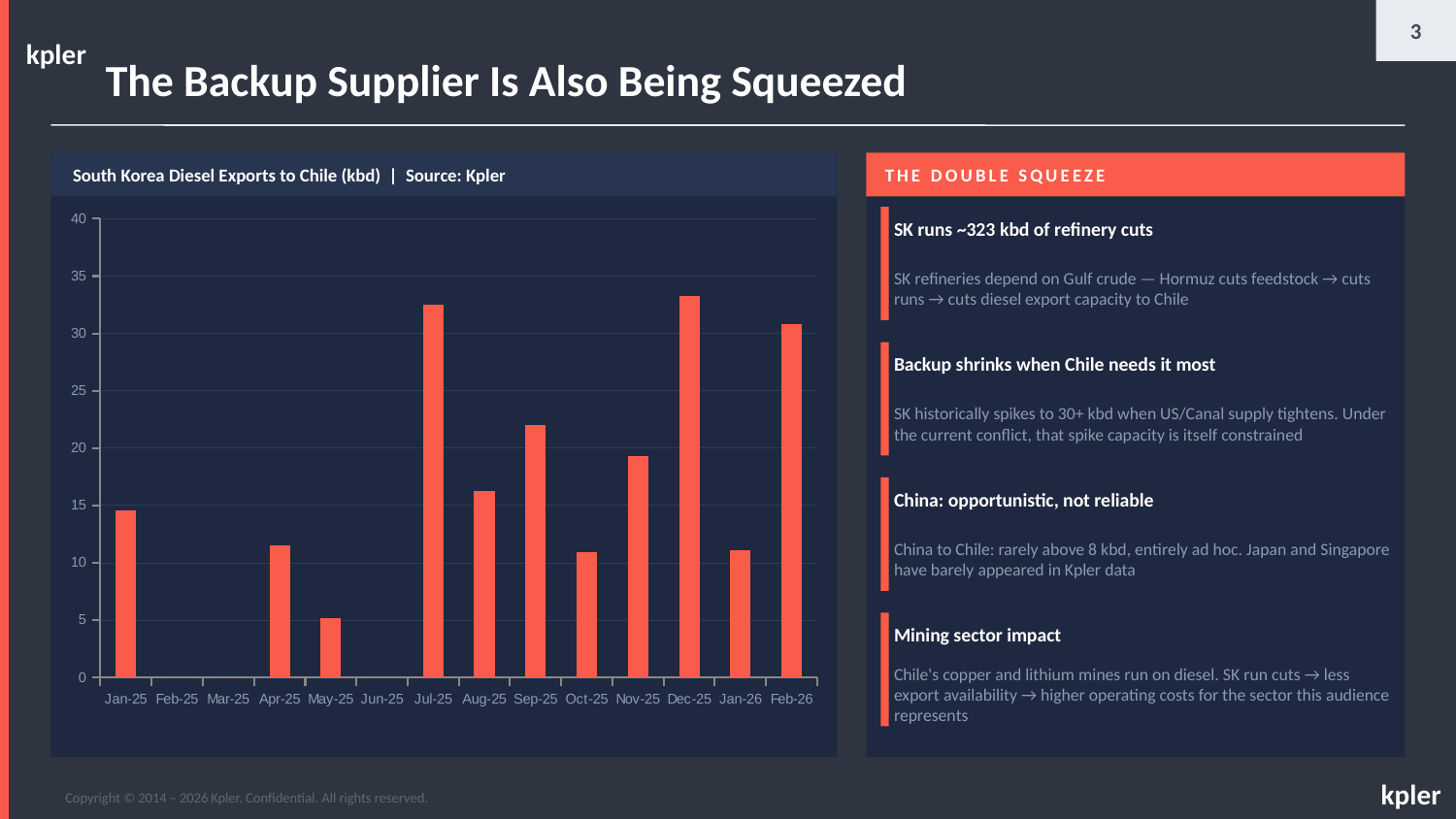
Which is larger, the value for Jul-25 or the value for Aug-25? Jul-25 What is the title of the chart on the slide? South Korea Diesel Exports to Chile (kbd) Is the value for Sep-25 greater or less than 20? greater What kind of chart is shown on the slide? bar chart What source is cited for the chart? Kpler Which is larger, the value for Sep-25 or the value for Oct-25? Sep-25 Is the value for Feb-26 greater or less than 25? greater Is the value for Jul-25 greater or less than 30? greater How many months are shown on the x axis of the chart? 14 Which is larger, the value for Apr-25 or the value for May-25? Apr-25